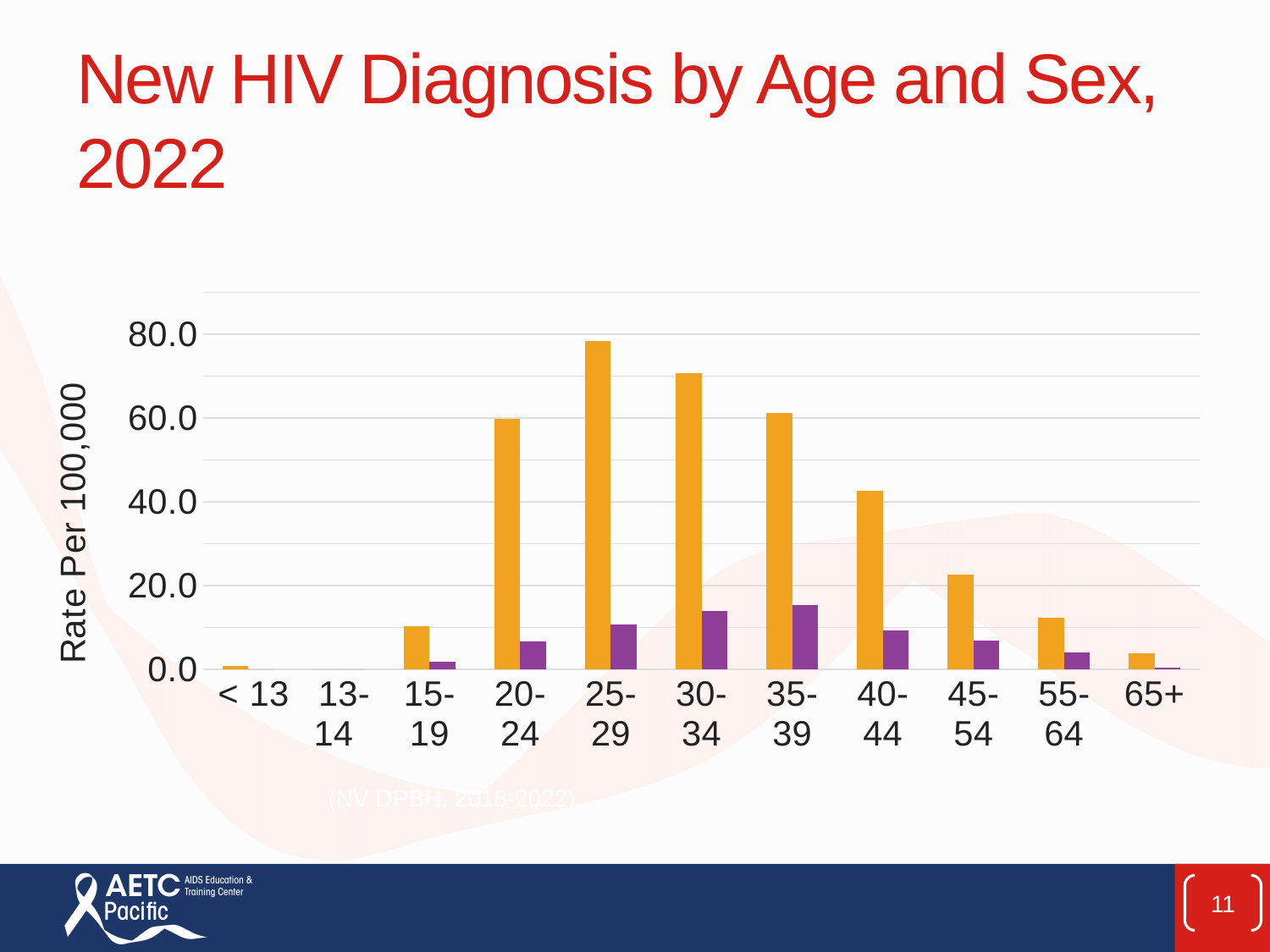
Which is larger, the purple bar for 20-24 or the purple bar for 25-29? 25-29 Is the orange bar for the 45-54 age group greater or less than 20.0? greater Do the orange bars rise or fall from the 25-29 age group to the 65+ age group? fall Is the orange bar for the 40-44 age group greater or less than 60.0? less Is the orange bar for the 25-29 age group greater or less than 60.0? greater What is the label on the vertical axis of the chart? Rate Per 100,000 Which is larger, the orange bar for 30-34 or the orange bar for 35-39? 30-34 Which age group has the highest purple bar? 35-39 Which age group has the highest orange bar? 25-29 What kind of chart is shown on the slide? bar chart How many age-group categories are shown on the x axis? 11